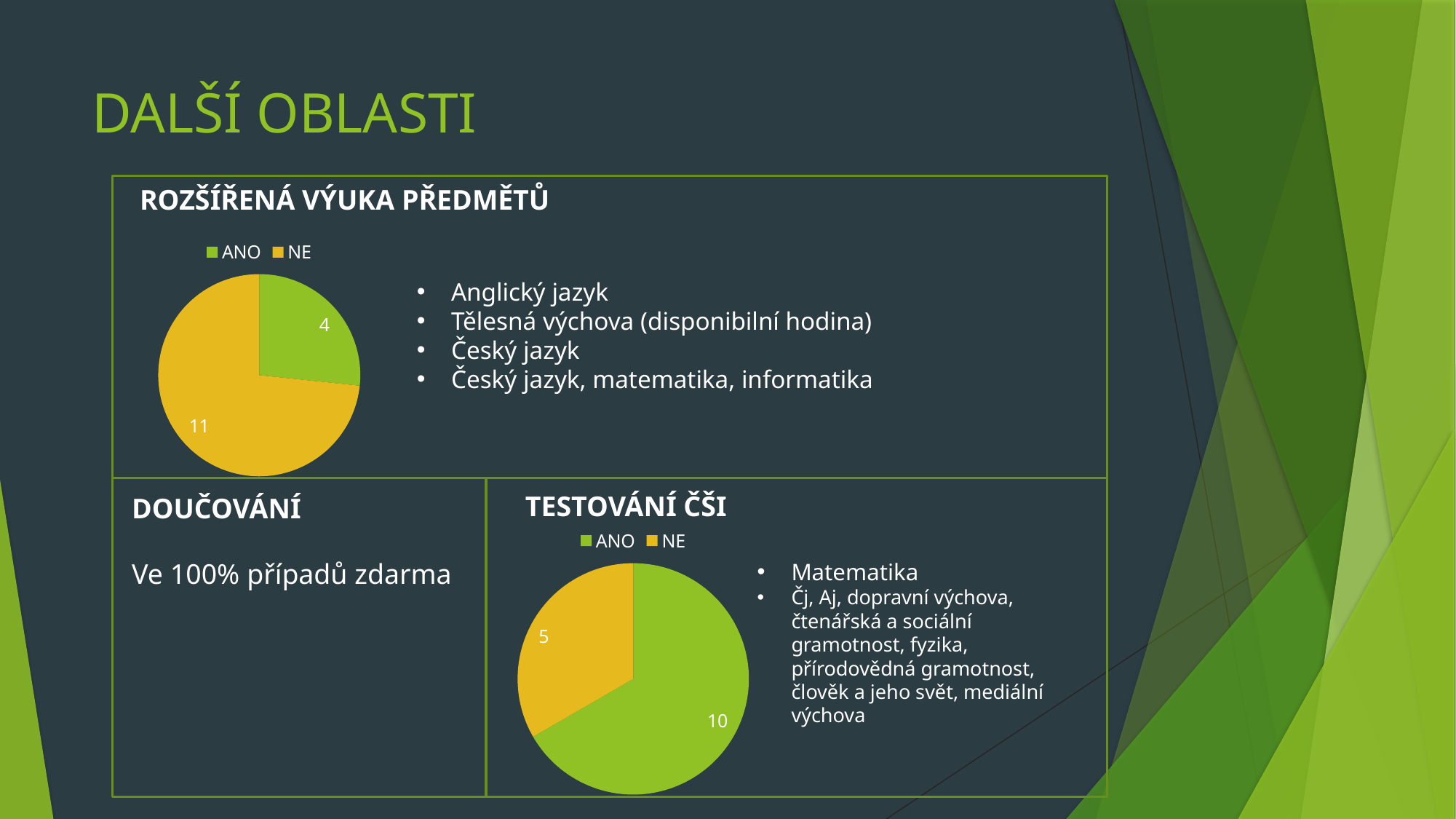
In the ROZŠÍŘENÁ VÝUKA PŘEDMĚTŮ chart, which category has the largest slice? NE In the TESTOVÁNÍ ČŠI chart, what is the value for NE? 5 How many categories does the TESTOVÁNÍ ČŠI chart legend list? 2 In the TESTOVÁNÍ ČŠI chart, which category has the smallest slice? NE In the TESTOVÁNÍ ČŠI chart, what is the difference between ANO and NE? 5 In the TESTOVÁNÍ ČŠI chart, is ANO larger or smaller than NE? larger In the ROZŠÍŘENÁ VÝUKA PŘEDMĚTŮ chart, what is the value for NE? 11 In the ROZŠÍŘENÁ VÝUKA PŘEDMĚTŮ chart, what colour is the ANO slice? green In the ROZŠÍŘENÁ VÝUKA PŘEDMĚTŮ chart, what is the difference between NE and ANO? 7 In the ROZŠÍŘENÁ VÝUKA PŘEDMĚTŮ chart, what is the value for ANO? 4 What type of chart is used in the ROZŠÍŘENÁ VÝUKA PŘEDMĚTŮ section? pie chart In the TESTOVÁNÍ ČŠI chart, what is the value for ANO? 10